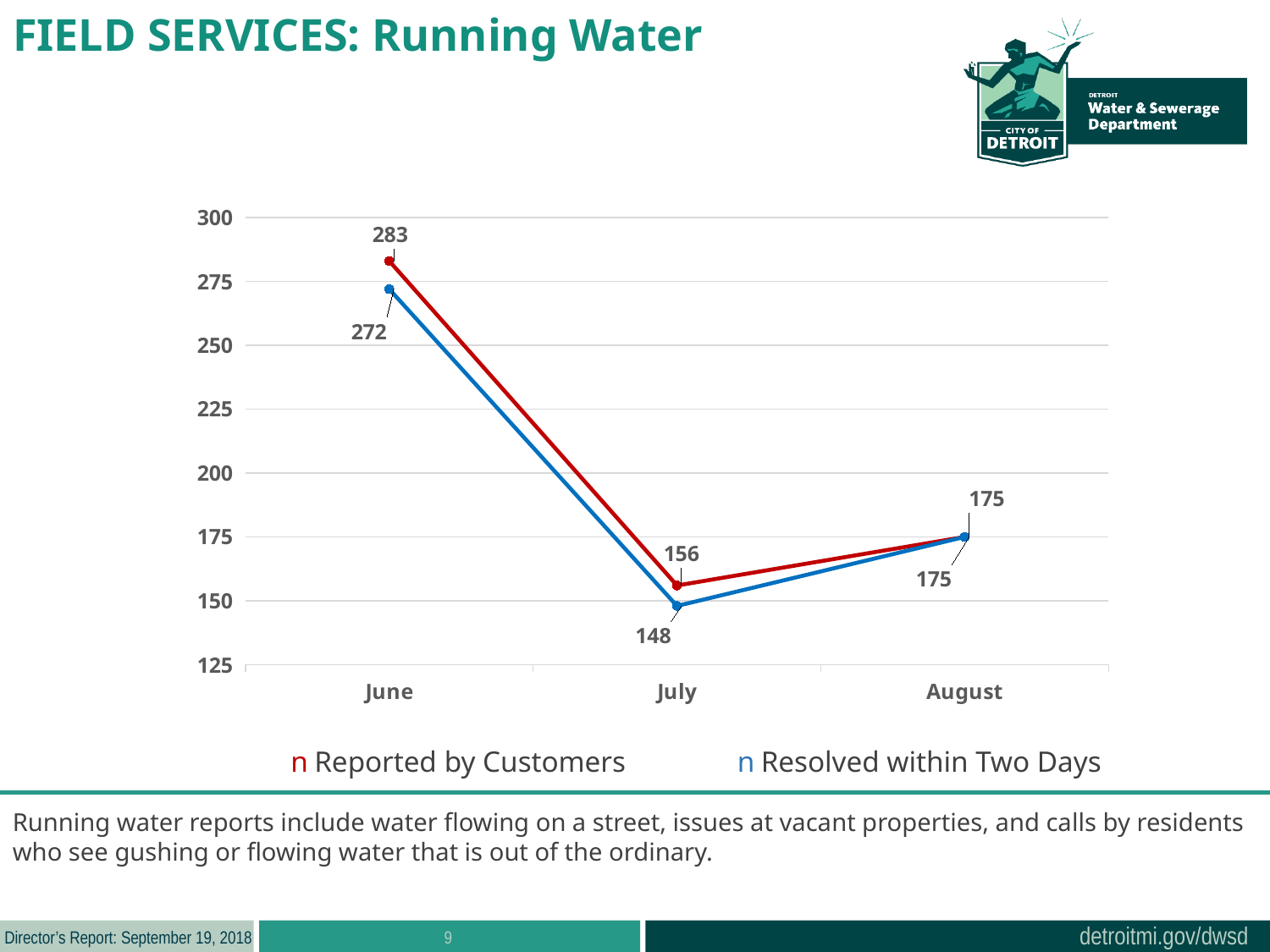
How many months are shown on the x axis? 3 What is the difference between Reported by Customers in June and in July? 127 What kind of chart is shown on the slide? Line chart Which month has the lowest value for Resolved within Two Days? July Does the Reported by Customers line rise or fall from June to July? Fall Which is larger in July: Reported by Customers or Resolved within Two Days? Reported by Customers What is the value for Reported by Customers in June? 283 What is the value for Reported by Customers in August? 175 What is the value for Resolved within Two Days in July? 148 Which month has the highest value for Reported by Customers? June What is the difference between Reported by Customers and Resolved within Two Days in June? 11 How many series does the legend list? 2